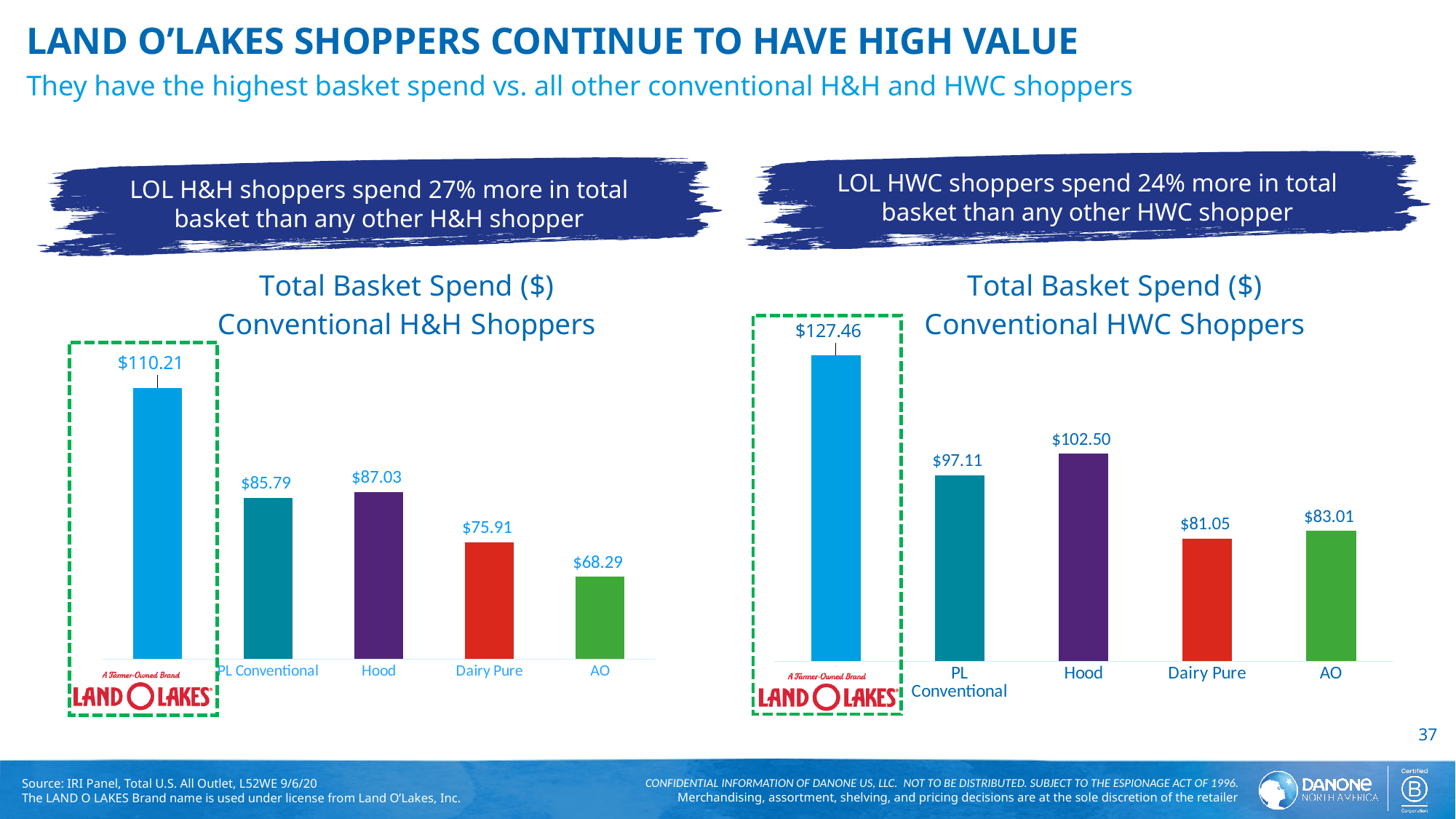
How many categories are shown in the Conventional H&H Shoppers chart? 5 In the Conventional HWC Shoppers chart, which category has the highest total basket spend? Land O'Lakes In the Conventional HWC Shoppers chart, what is the difference between the Hood value and the Dairy Pure value? $21.45 In the Conventional HWC Shoppers chart, what is the total basket spend for Hood? $102.50 In the Conventional HWC Shoppers chart, which category has the lowest total basket spend? Dairy Pure In the Conventional H&H Shoppers chart, which category has the lowest total basket spend? AO In the Conventional H&H Shoppers chart, which is larger, the value for Hood or the value for PL Conventional? Hood In the Conventional H&H Shoppers chart, what is the value for Dairy Pure? $75.91 In the Conventional HWC Shoppers chart, which is larger, the value for AO or the value for Dairy Pure? AO In the Conventional H&H Shoppers chart, what is the total basket spend for Land O'Lakes? $110.21 In the Conventional H&H Shoppers chart, what is the difference between the Land O'Lakes value and the PL Conventional value? $24.42 What kind of chart is the Conventional HWC Shoppers chart? Bar chart